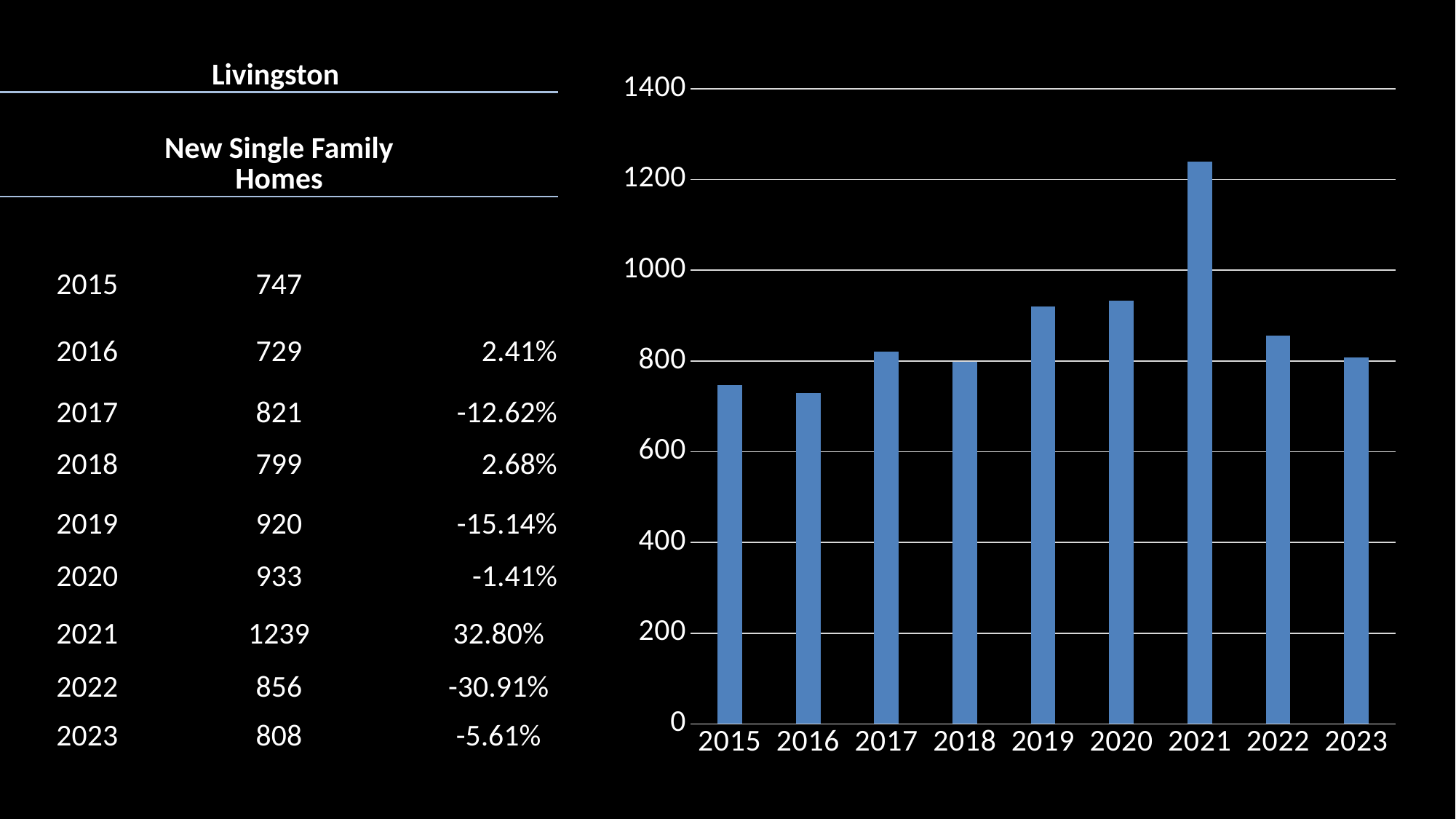
What kind of chart is shown on the slide? bar chart How many years are plotted on the bar chart? 9 Is the value for 2021 greater or less than 1200? greater Which is larger, the value for 2019 or the value for 2022? 2019 Is the value for 2016 greater or less than 800? less What is the value for 2023 on the chart? 808 What is the value for 2021 on the chart? 1239 Which year has the lowest bar on the chart? 2016 Which year has the highest bar on the chart? 2021 What is the difference between the values for 2021 and 2022? 383 Do the values rise or fall from 2021 to 2023? fall What is the value for 2015 on the chart? 747